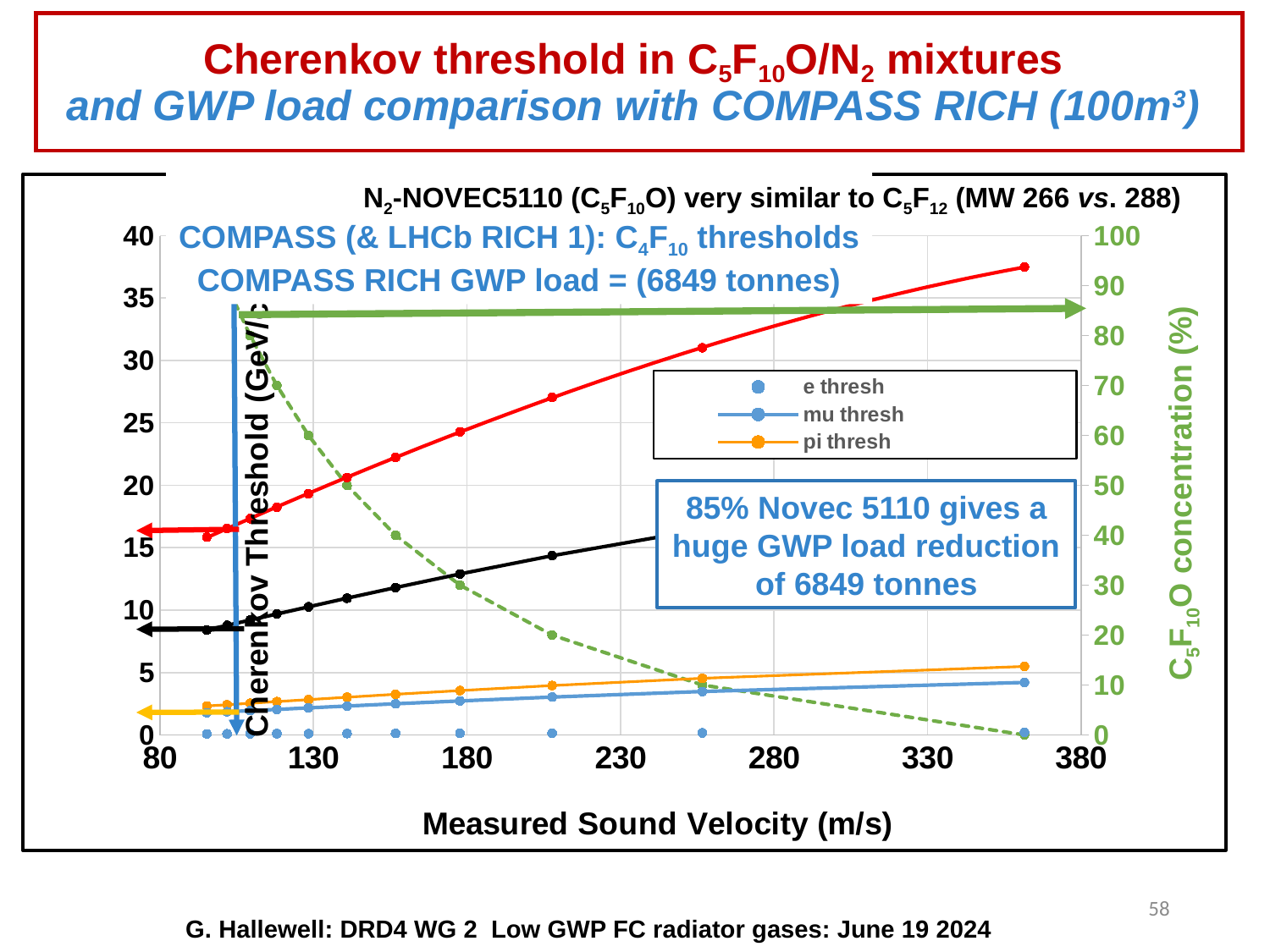
Are the e thresh values greater or less than 5 GeV/c across the plotted range? less What kind of chart is shown on the slide? line chart What are the three entries listed in the chart legend? e thresh, mu thresh, pi thresh Does the pi thresh series rise or fall as the measured sound velocity increases? rise Is the pi thresh value at the highest plotted sound velocity (about 360 m/s) greater or less than 10 GeV/c? less What is the title of the x axis of the chart? Measured Sound Velocity (m/s) At the highest plotted sound velocity, which is larger: the pi thresh value or the mu thresh value? pi thresh Does the green dashed C5F10O concentration curve rise or fall as the measured sound velocity increases? fall Is the value of the black curve at about 240 m/s greater or less than 20 GeV/c? less How many series does the legend list? 3 At a measured sound velocity of about 180 m/s, which curve is higher: the red curve or the black curve? the red curve